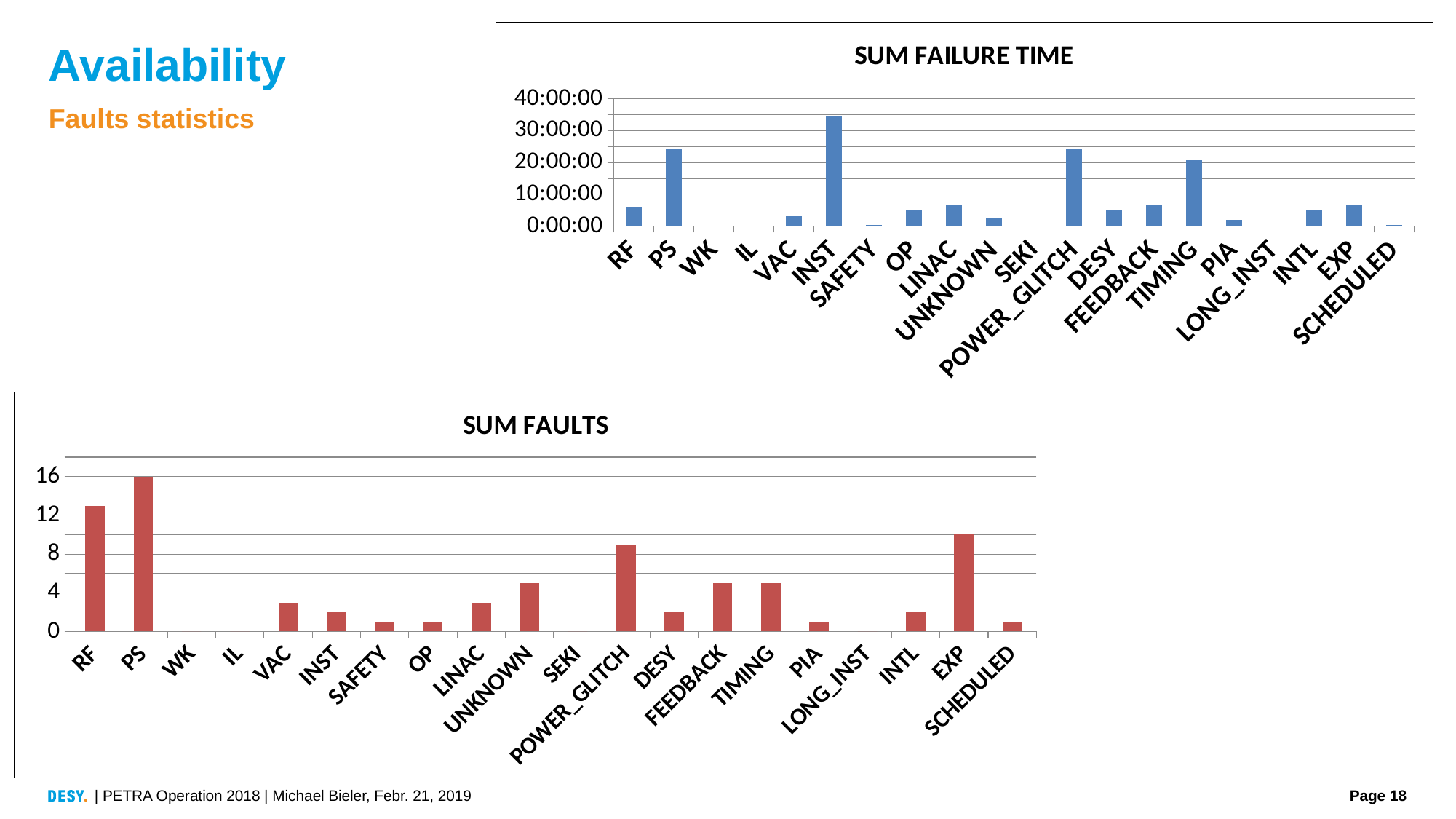
In the SUM FAULTS chart, which category has the highest value? PS In the SUM FAILURE TIME chart, which is larger, the value for INST or the value for TIMING? INST In the SUM FAULTS chart, is the value for RF greater or less than 12? greater What is the title of the chart in the lower left of the slide? SUM FAULTS How many categories are shown on the x axis of the SUM FAULTS chart? 20 In the SUM FAULTS chart, is the value for POWER_GLITCH greater or less than 8? greater In the SUM FAILURE TIME chart, which category has the highest value? INST What kind of chart is the SUM FAILURE TIME chart? bar chart In the SUM FAILURE TIME chart, is the value for RF greater or less than 10:00:00? less In the SUM FAULTS chart, what is the value for PS? 16 In the SUM FAULTS chart, which is larger, the value for RF or the value for PS? PS